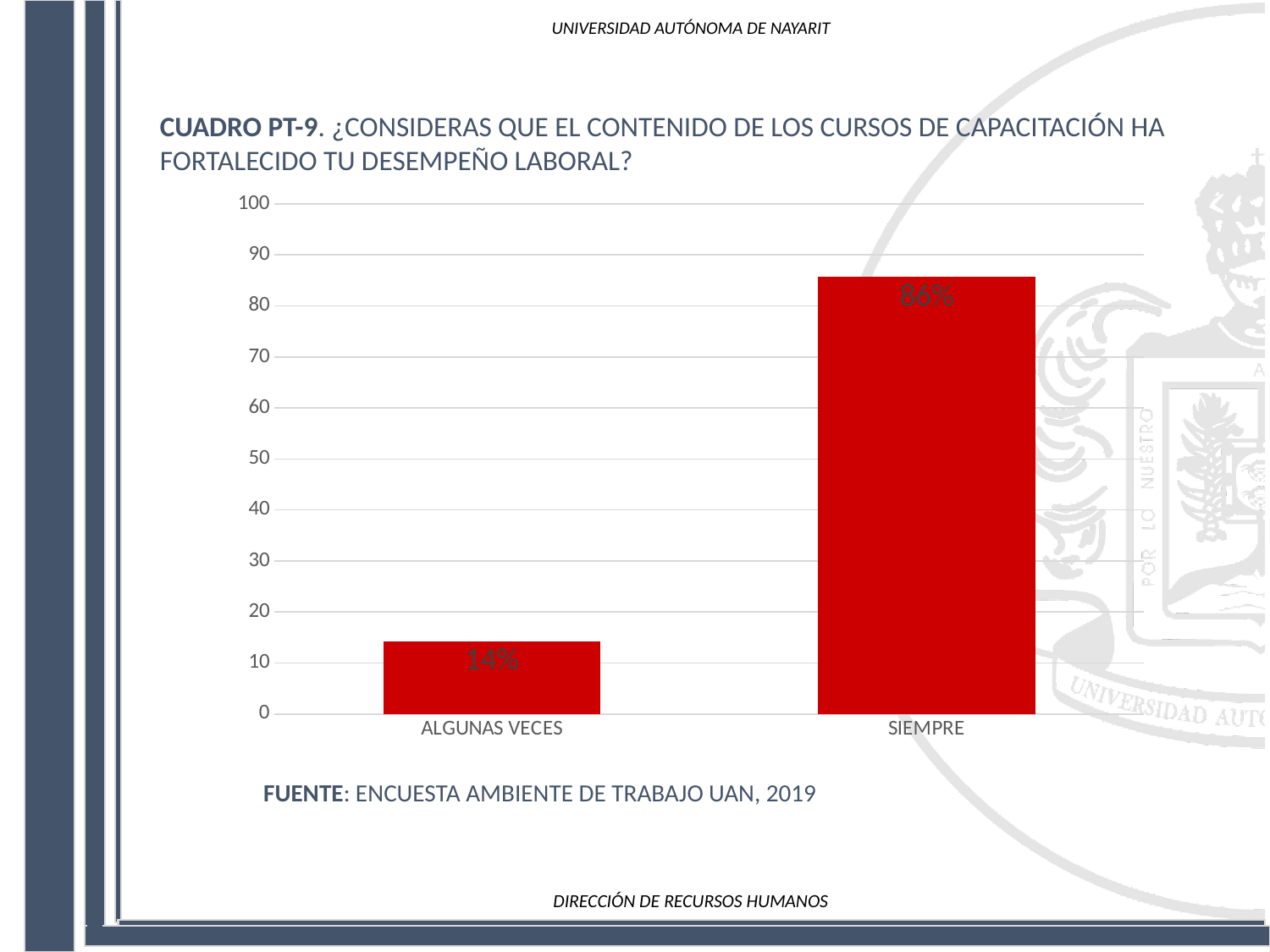
What colour are the bars in the chart? Red What is the value for ALGUNAS VECES? 14% Is the value for ALGUNAS VECES greater or less than 20? less How many categories are shown on the x axis? 2 What is the value for SIEMPRE? 86% What kind of chart is shown on the slide? Bar chart What is the source cited below the chart? ENCUESTA AMBIENTE DE TRABAJO UAN, 2019 Which is larger, the value for ALGUNAS VECES or the value for SIEMPRE? SIEMPRE Is the value for SIEMPRE greater or less than 80? greater Which category has the highest value? SIEMPRE Which category has the lowest value? ALGUNAS VECES What is the difference between the values for SIEMPRE and ALGUNAS VECES? 72%